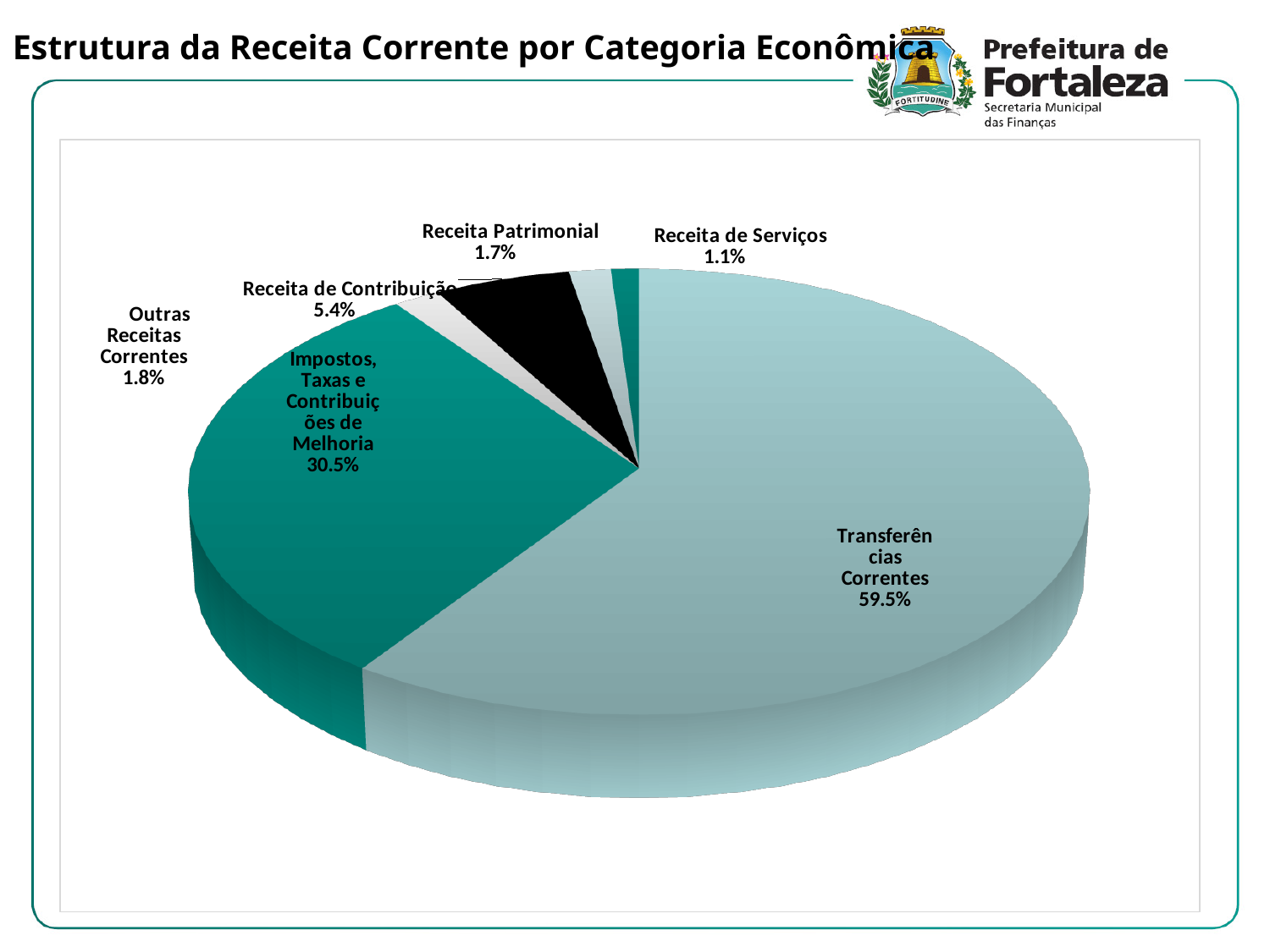
What is the value shown for Receita Patrimonial? 1.7% What is the value shown for Receita de Contribuição? 5.4% What share of the pie does Transferências Correntes represent? 59.5% Which is larger, Outras Receitas Correntes or Receita Patrimonial? Outras Receitas Correntes What kind of chart is shown on the slide? pie chart How many categories are shown in the pie chart? 6 What is the title of the slide containing the chart? Estrutura da Receita Corrente por Categoria Econômica Which category has the smallest slice of the pie? Receita de Serviços What is the difference in percentage points between Transferências Correntes and Impostos, Taxas e Contribuições de Melhoria? 29 percentage points Which category has the largest slice of the pie? Transferências Correntes What is the value shown for Outras Receitas Correntes? 1.8% What is the value shown for Impostos, Taxas e Contribuições de Melhoria? 30.5%